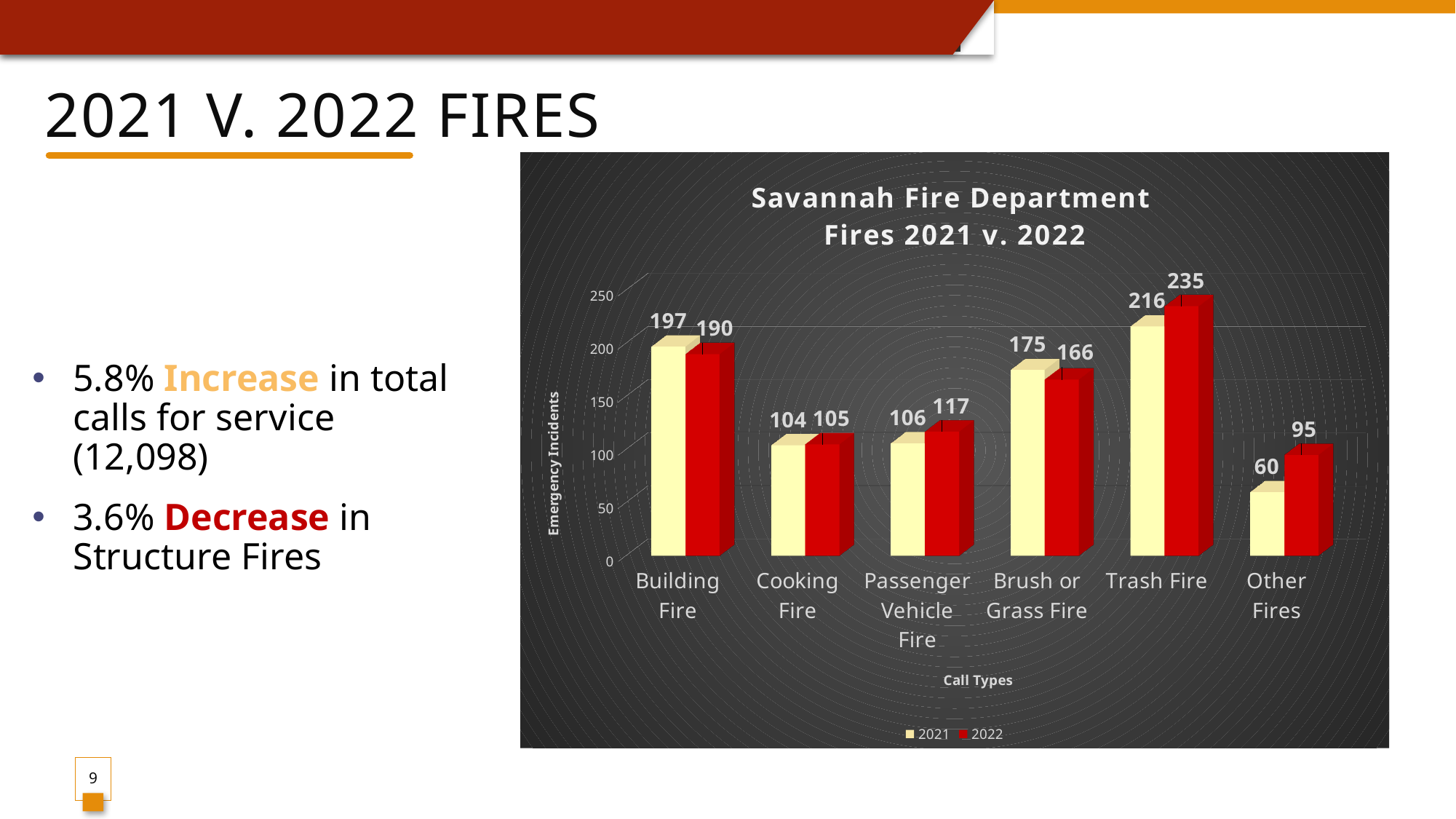
Which call type had the lowest number of incidents in 2021? Other Fires What is the difference between the 2021 and 2022 values for Brush or Grass Fire? 9 What is the difference between the 2022 and 2021 values for Trash Fire? 19 How many call types are shown on the x axis? 6 What was the number of Passenger Vehicle Fire incidents in 2022? 117 How many series does the legend list? 2 What was the number of Building Fire incidents in 2021? 197 What was the number of Other Fires incidents in 2022? 95 What is the label of the vertical axis? Emergency Incidents What kind of chart is shown on the slide? Bar chart Which is larger for Other Fires, the 2021 value or the 2022 value? 2022 Which call type had the highest number of incidents in 2022? Trash Fire